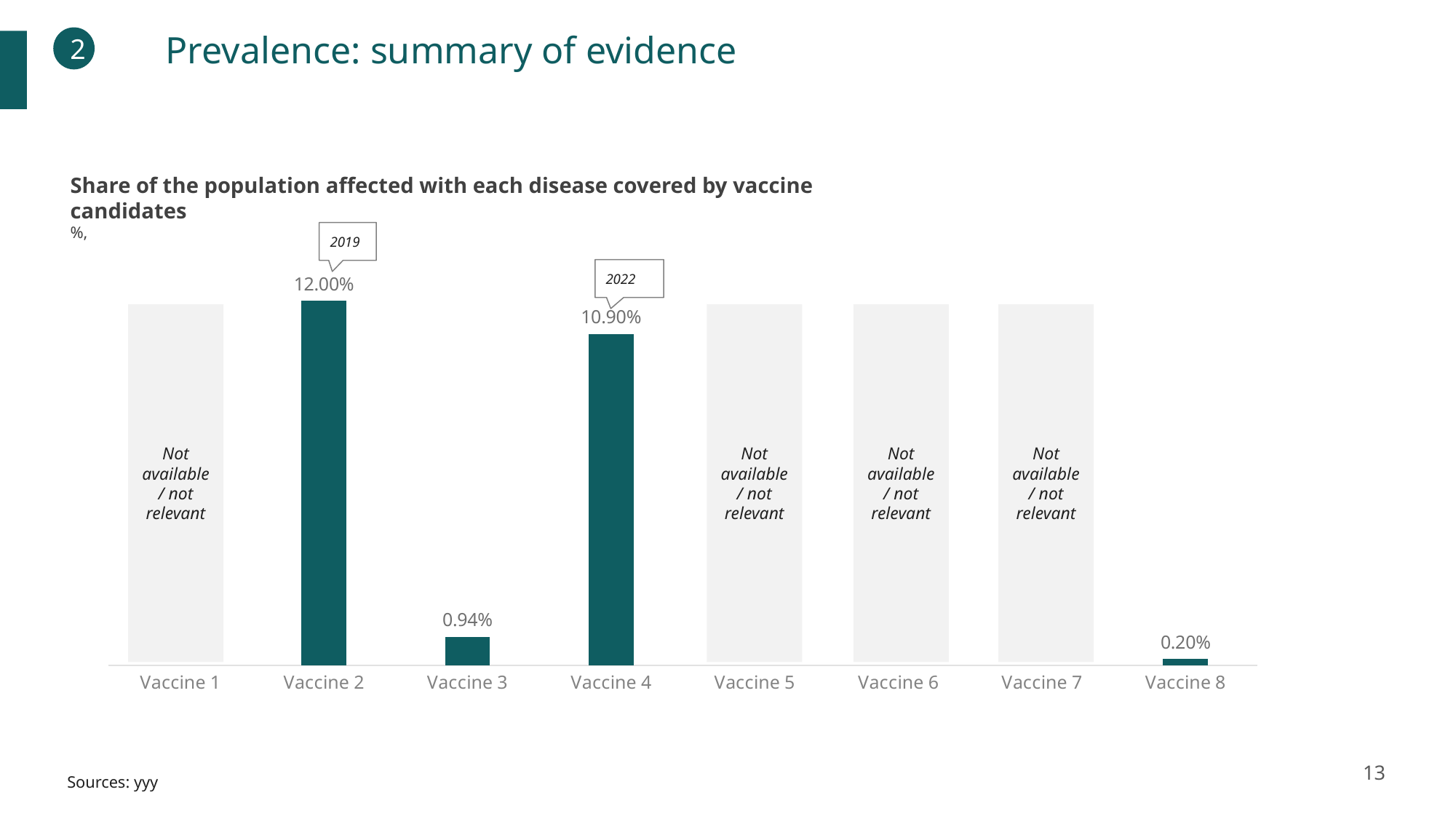
Which vaccine has the highest share of the population affected? Vaccine 2 How many vaccines are marked as 'Not available / not relevant'? 4 Among the vaccines with a plotted value, which has the lowest share? Vaccine 8 What is the value for Vaccine 3? 0.94% Which is larger, the value for Vaccine 3 or the value for Vaccine 8? Vaccine 3 Which year is annotated above the bar for Vaccine 4? 2022 What kind of chart is shown on the slide? Bar chart What is the difference between the values for Vaccine 2 and Vaccine 4? 1.10% How many vaccine categories are shown on the x axis? 8 What is the value for Vaccine 2? 12.00% What is the value for Vaccine 8? 0.20% What is the value for Vaccine 4? 10.90%